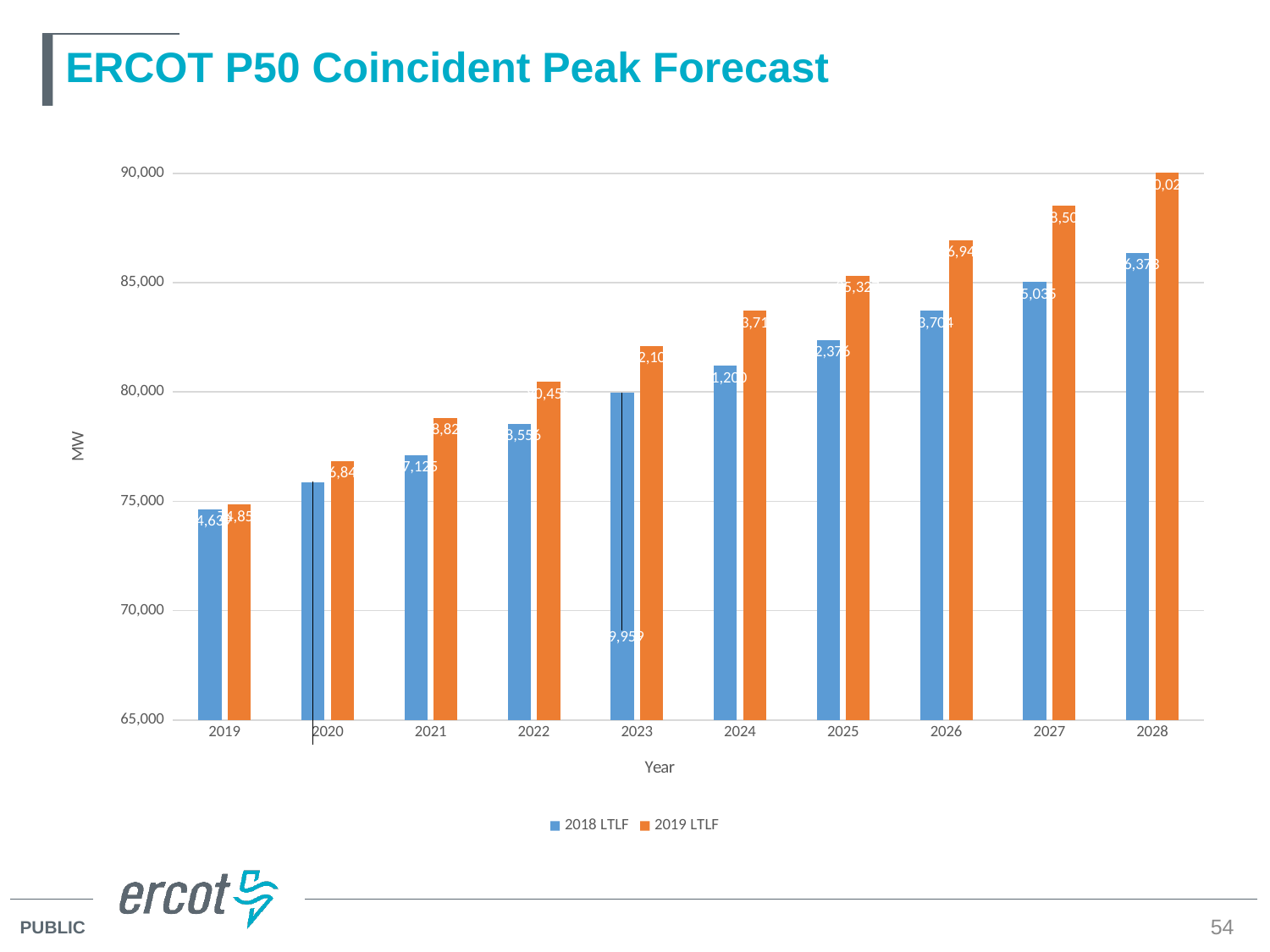
Which year has the highest 2019 LTLF value? 2028 In 2028, which series has the larger value, 2018 LTLF or 2019 LTLF? 2019 LTLF Is the 2018 LTLF value for 2028 greater or less than 85,000? greater In 2025, which series has the larger value, 2018 LTLF or 2019 LTLF? 2019 LTLF How many years are shown on the x axis? 10 Do the 2019 LTLF values rise or fall from 2019 to 2028? Rise How many series does the legend list? 2 Which year has the lowest 2018 LTLF value? 2019 Is the 2018 LTLF value for 2019 greater or less than 75,000? less Is the 2019 LTLF value for 2024 greater or less than 80,000? greater What is the label on the y axis of the chart? MW What kind of chart is shown on the slide? Bar chart